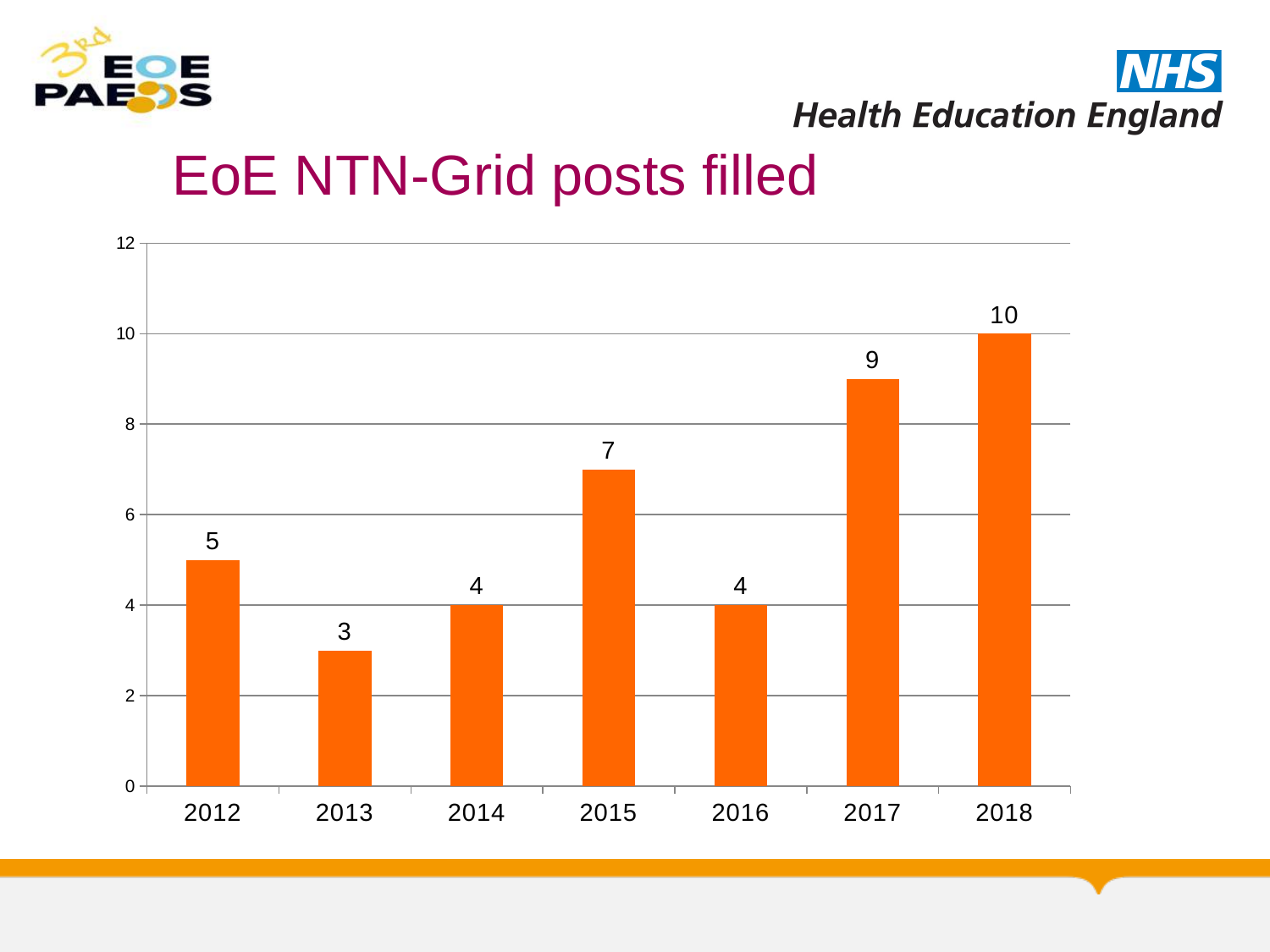
Which year has the larger value, 2017 or 2015? 2017 What colour are the bars in the chart? Orange What is the value shown for 2013? 3 Do the values generally rise or fall from 2016 to 2018? Rise How many years are shown on the x axis? 7 Which year has the lowest number of posts filled? 2013 How many NTN-Grid posts were filled in 2015? 7 What is the difference between the values for 2018 and 2012? 5 What is the title of the chart? EoE NTN-Grid posts filled What kind of chart is shown on the slide? Bar chart Which year has the highest number of posts filled? 2018 Is the value for 2017 greater or less than 8? greater